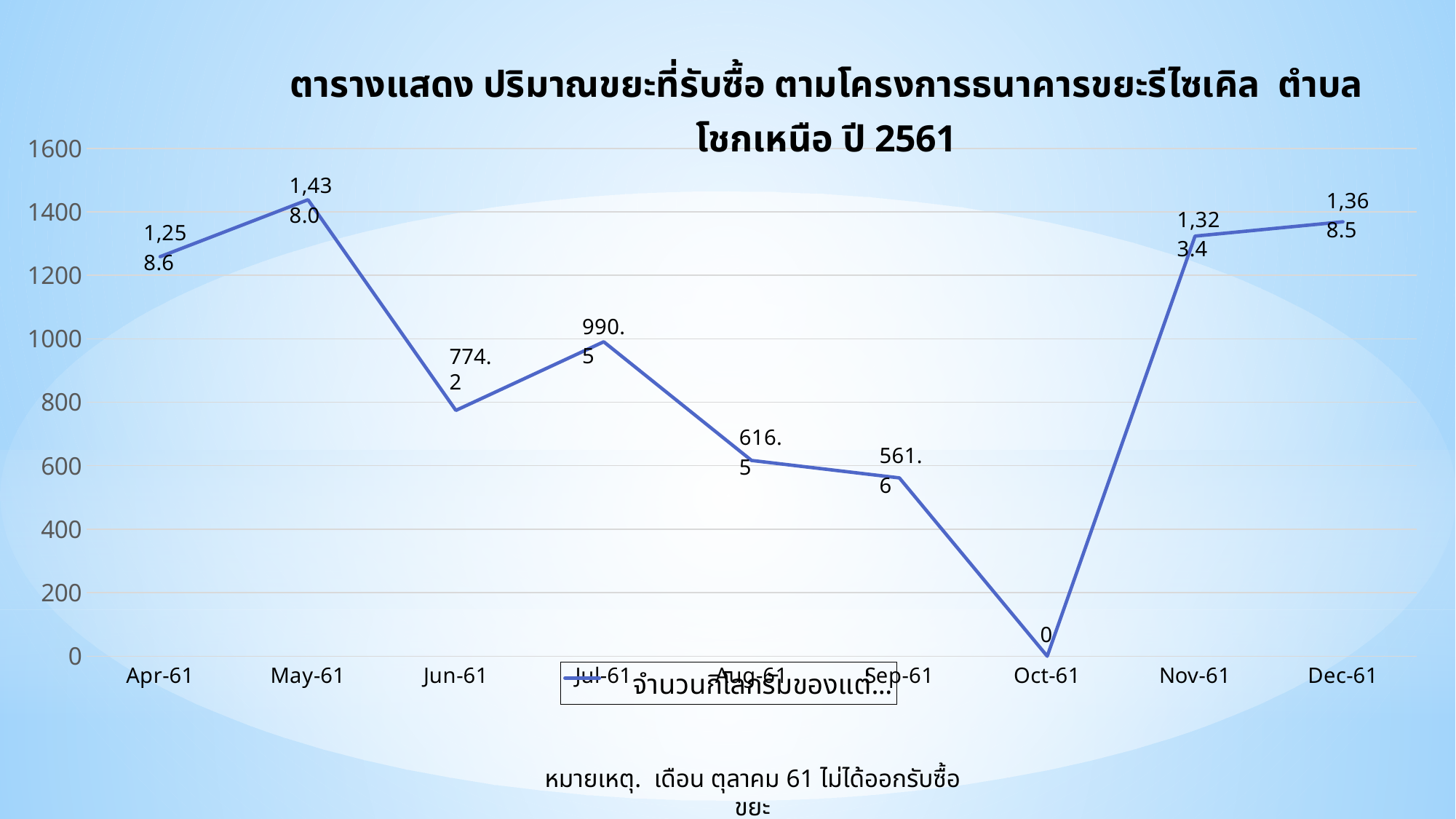
Is the value for Jun-61 greater or less than 800? less Which is larger, the value for Apr-61 or the value for Dec-61? Dec-61 Which month has the highest value? May-61 Do the values rise or fall from Jul-61 to Oct-61? fall Which month has the lowest value? Oct-61 How many series does the legend list? 1 How many months (data points) are plotted on the chart? 9 What is the value for May-61? 1,438.0 What kind of chart is shown on the slide? line chart What is the value for Sep-61? 561.6 What is the difference between the values for Jul-61 and Jun-61? 216.3 What is the value for Oct-61? 0